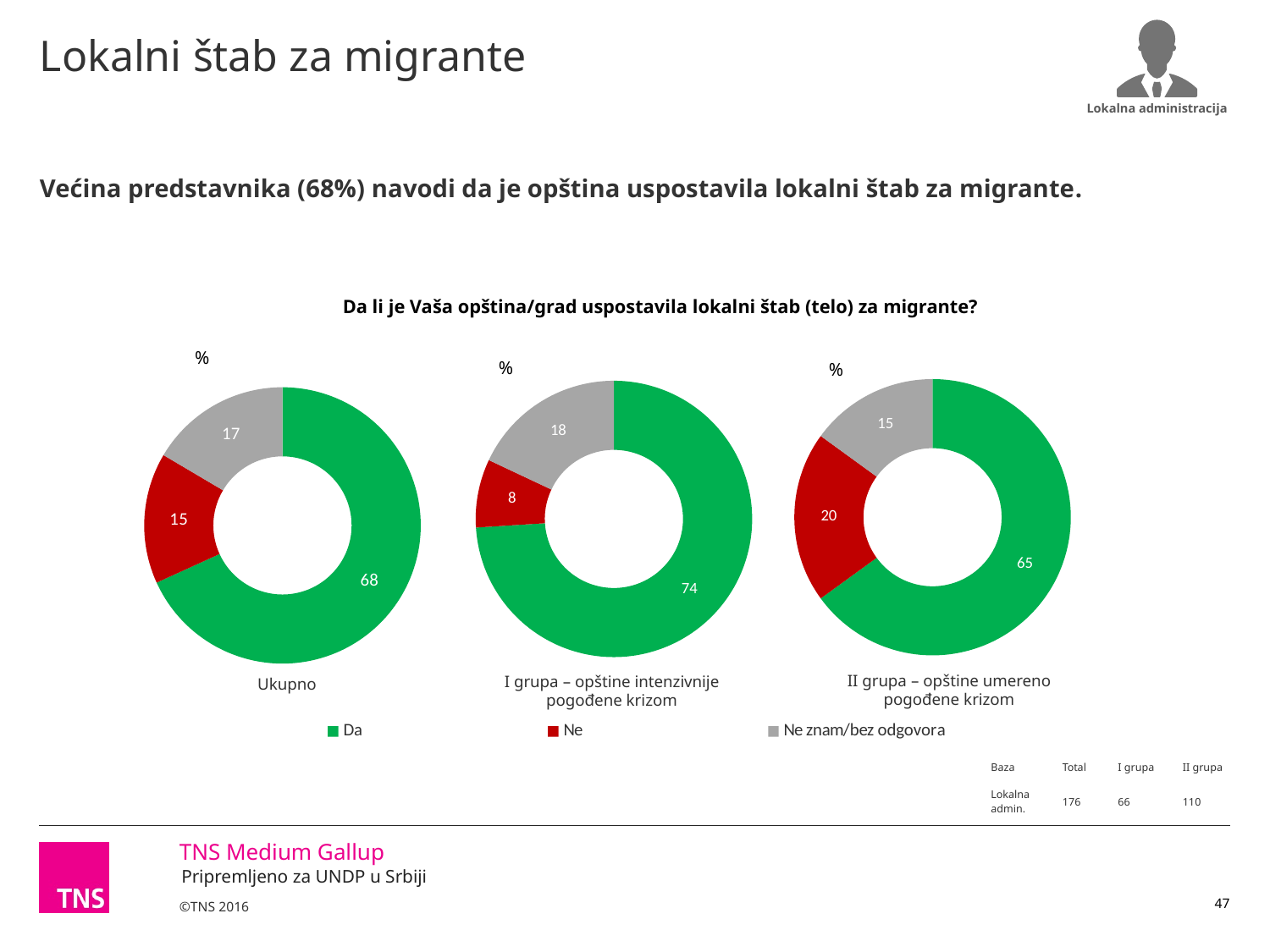
How many slices does the 'Ukupno' chart have? 3 What type of chart is used for 'Ukupno'? Donut (pie) chart In the 'II grupa – opštine umereno pogođene krizom' chart, what is the difference between the 'Da' and 'Ne' values? 45 In the 'I grupa – opštine intenzivnije pogođene krizom' chart, what is the value for 'Ne'? 8 In the 'Ukupno' chart, what percentage answered 'Da'? 68 In the 'I grupa – opštine intenzivnije pogođene krizom' chart, which category has the smallest share? Ne In the 'II grupa – opštine umereno pogođene krizom' chart, which category has the smallest share? Ne znam/bez odgovora In the 'Ukupno' chart, which is larger, 'Ne' or 'Ne znam/bez odgovora'? Ne znam/bez odgovora In the 'Ukupno' chart, which category has the largest share? Da How many entries does the legend list? 3 Which is larger: the 'Da' value in the 'I grupa' chart or the 'Da' value in the 'II grupa' chart? I grupa In the 'II grupa – opštine umereno pogođene krizom' chart, what is the value for 'Ne znam/bez odgovora'? 15